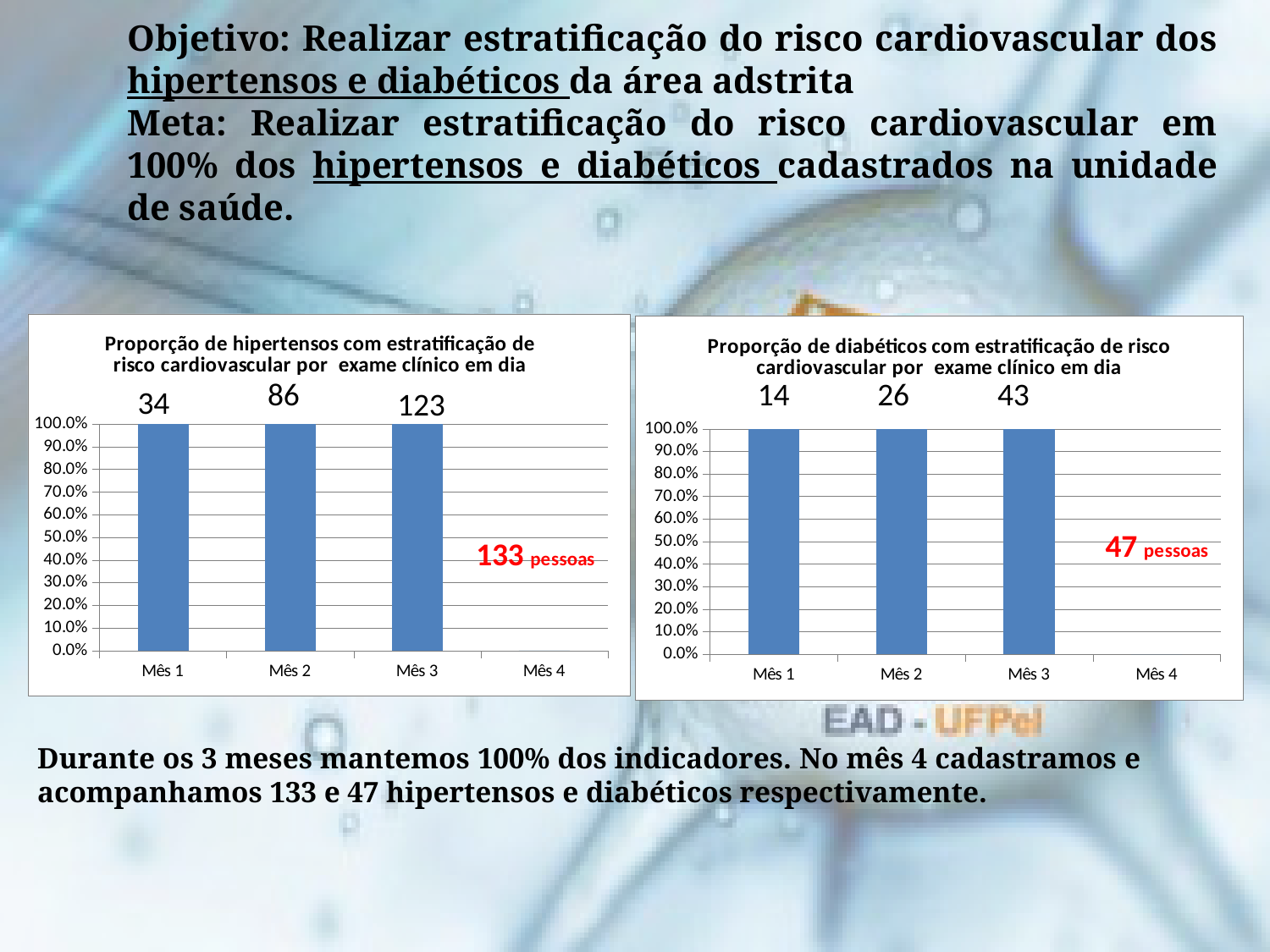
In the left chart (hipertensos), what percentage does the bar for Mês 1 reach on the y axis? 100.0% In the left chart (hipertensos), what is the difference between the numbers printed above the bars for Mês 2 and Mês 1? 52 In the right chart (diabéticos), is the bar for Mês 2 greater or less than 50.0%? greater What red text is shown at the Mês 4 position in the right chart (diabéticos)? 47 pessoas In the left chart (hipertensos), do the bar heights rise, fall or stay the same from Mês 1 to Mês 3? Stay the same In the right chart (diabéticos), what number is printed above the bar for Mês 3? 43 In the left chart (hipertensos), what number is printed above the bar for Mês 3? 123 What kind of chart is the left chart, 'Proporção de hipertensos com estratificação de risco cardiovascular por exame clínico em dia'? Bar chart In the right chart (diabéticos), what is the difference between the numbers printed above the bars for Mês 3 and Mês 1? 29 In the right chart (diabéticos), what number is printed above the bar for Mês 1? 14 How many month categories are shown on the x axis of the right chart (diabéticos)? 4 In the left chart (hipertensos), what number is printed above the bar for Mês 2? 86